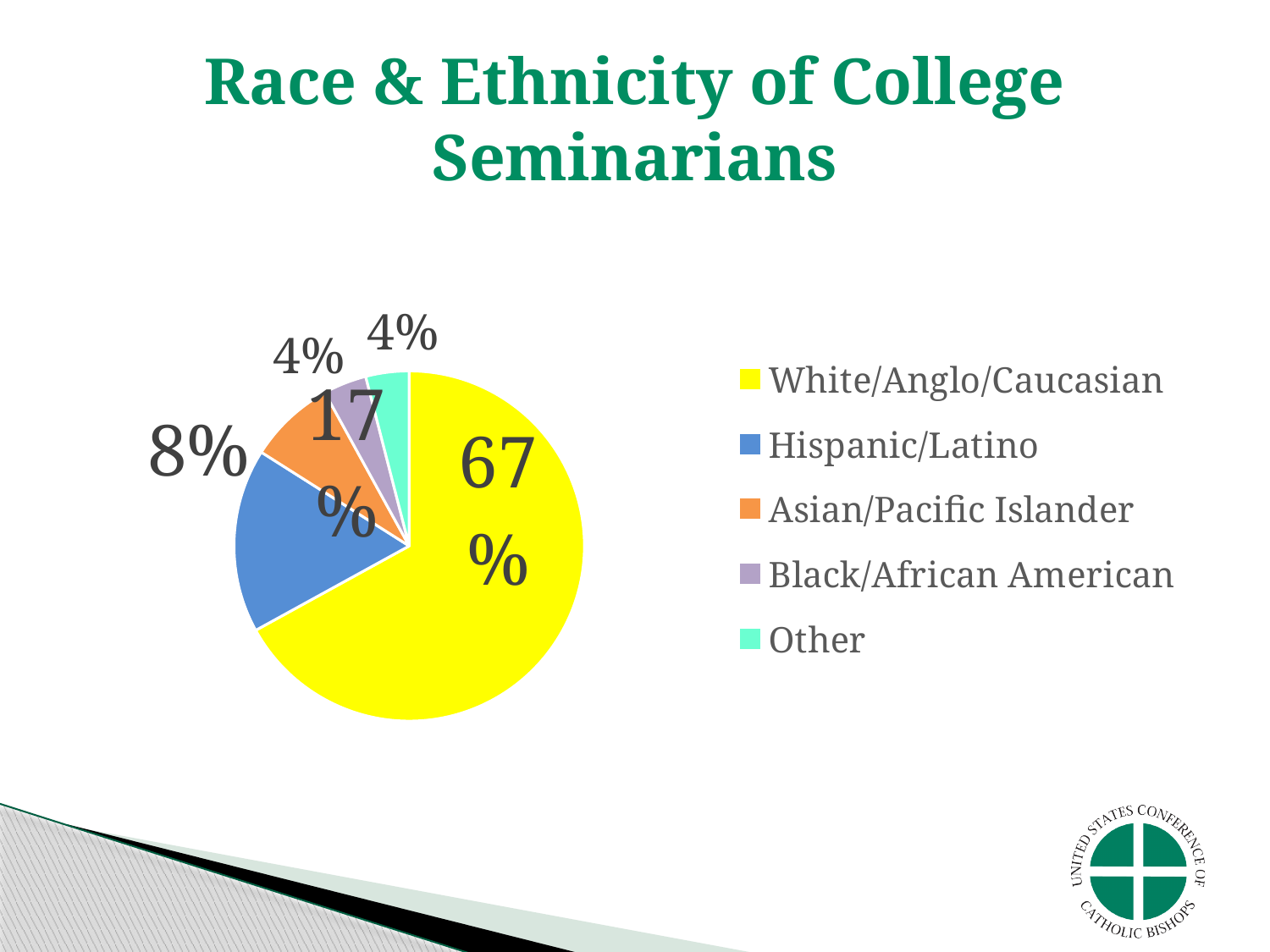
What colour represents Hispanic/Latino in the pie chart? Blue How many race/ethnicity categories are shown in the pie chart? 5 What is the difference in percentage points between the Hispanic/Latino and Asian/Pacific Islander shares? 9 What percentage of college seminarians are White/Anglo/Caucasian? 67% What percentage of college seminarians are Asian/Pacific Islander? 8% Which race/ethnicity category has the largest share of college seminarians? White/Anglo/Caucasian What percentage of college seminarians are Black/African American? 4% What is the difference in percentage points between the White/Anglo/Caucasian and Hispanic/Latino shares? 50 What percentage of college seminarians fall under Other? 4% Which is larger, the Hispanic/Latino share or the Asian/Pacific Islander share? Hispanic/Latino What percentage of college seminarians are Hispanic/Latino? 17% What type of chart is shown on the slide? Pie chart